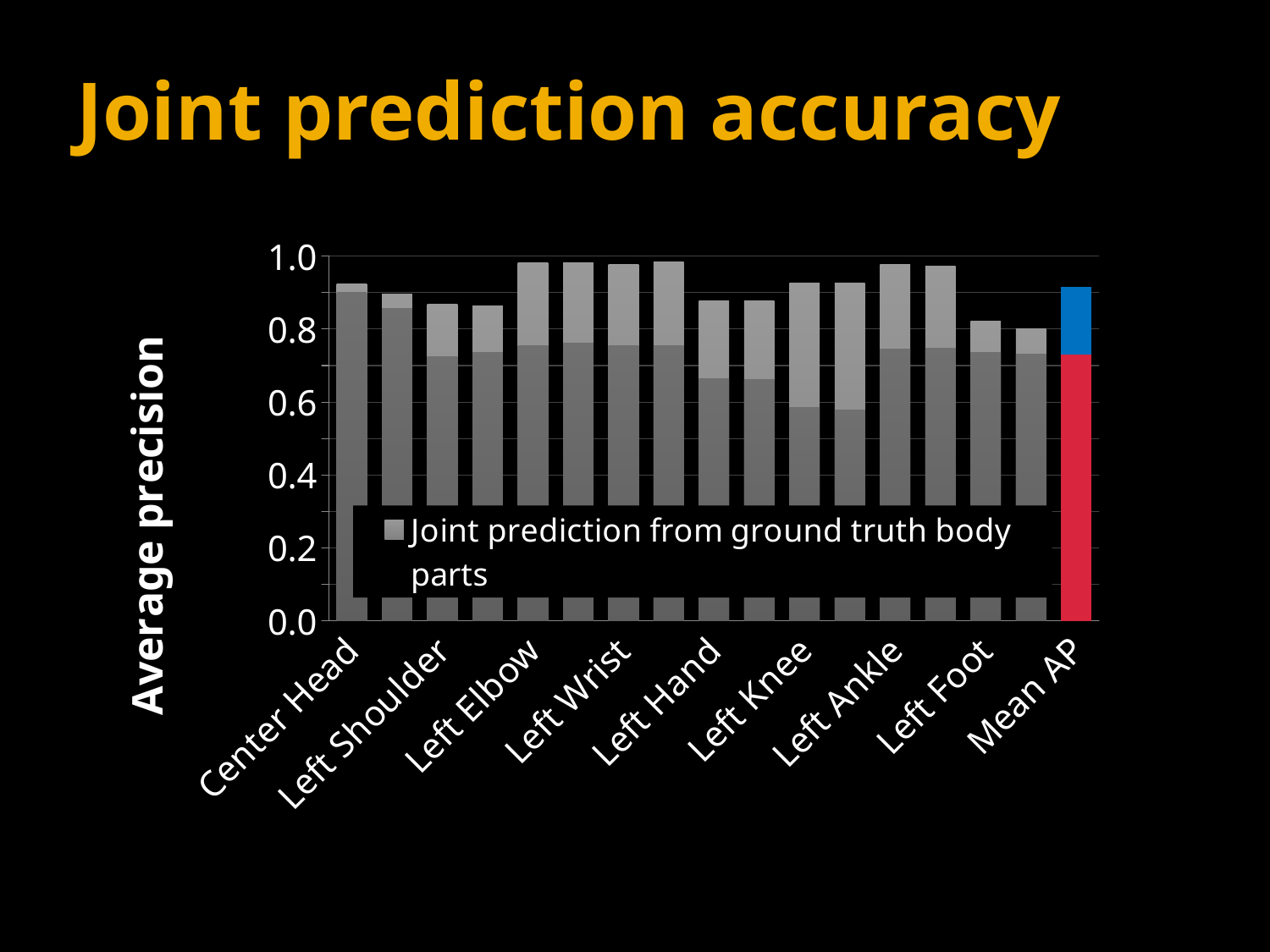
What is the title of the chart? Joint prediction accuracy Is the value for Center Head greater or less than 0.8? greater Which is larger, the value for Left Elbow or the value for Left Shoulder? Left Elbow How many category labels are printed along the x axis? 9 What kind of chart is shown on the slide? bar chart Which is larger, the value for Center Head or the value for Left Foot? Center Head Is the value for Left Foot greater or less than 0.6? greater What is the label of the vertical axis? Average precision